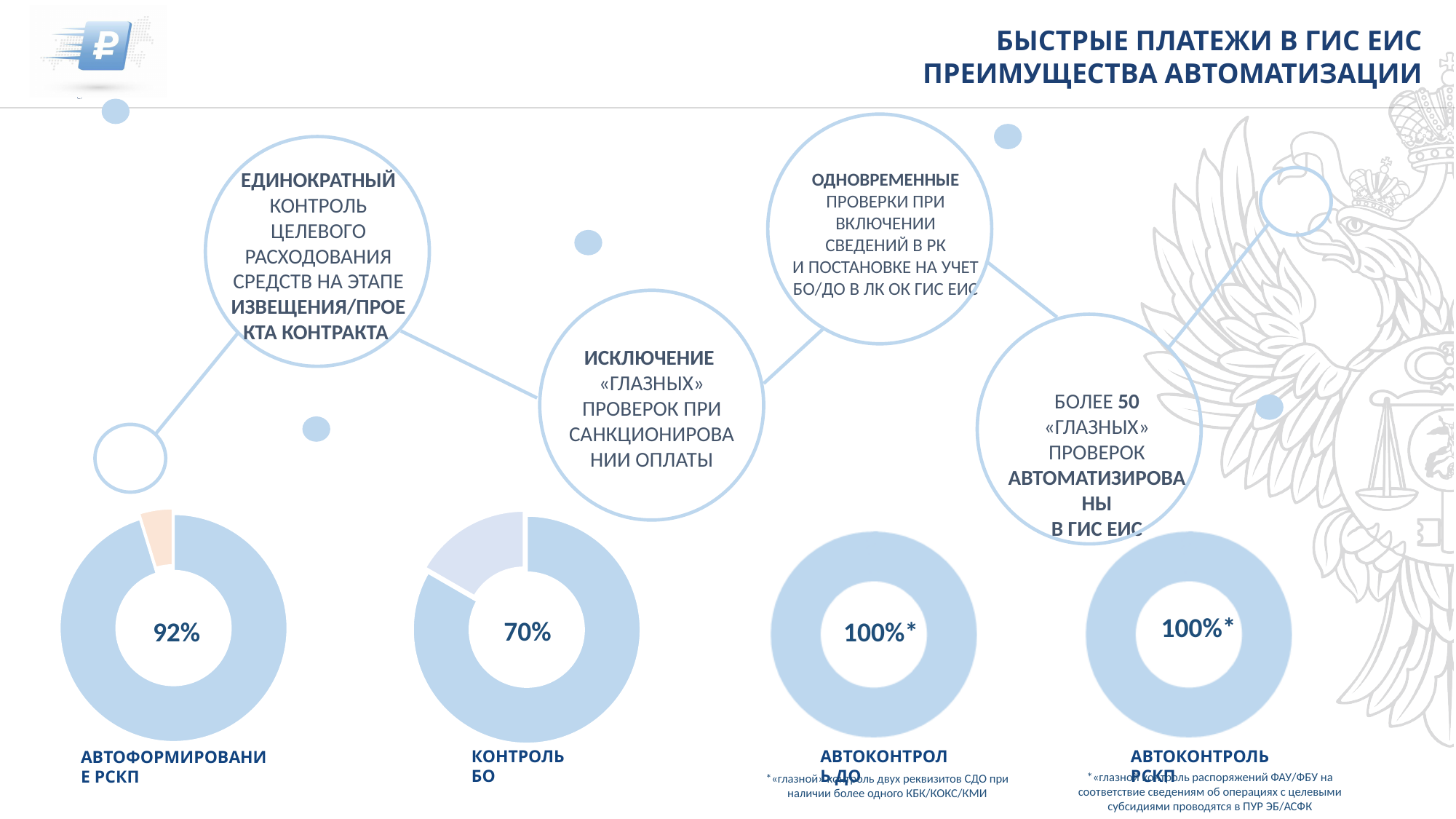
How many of the donut charts show a value of 100%*? 2 Which is larger, the value for АВТОФОРМИРОВАНИЕ РСКП or the value for КОНТРОЛЬ БО? АВТОФОРМИРОВАНИЕ РСКП Which donut chart shows the lowest percentage? КОНТРОЛЬ БО What value is shown in the centre of the donut chart labelled КОНТРОЛЬ БО? 70% What value is shown in the centre of the donut chart labelled АВТОФОРМИРОВАНИЕ РСКП? 92% What value is shown in the centre of the donut chart labelled АВТОКОНТРОЛЬ ДО? 100%* What kind of charts are shown along the bottom of the slide? Donut (pie) charts What is the difference in percentage points between the АВТОФОРМИРОВАНИЕ РСКП chart (92%) and the КОНТРОЛЬ БО chart (70%)? 22 percentage points How many donut charts are shown on the slide? 4 What value is shown in the centre of the donut chart labelled АВТОКОНТРОЛЬ РСКП? 100%* What is the title of the slide containing the donut charts? БЫСТРЫЕ ПЛАТЕЖИ В ГИС ЕИС ПРЕИМУЩЕСТВА АВТОМАТИЗАЦИИ